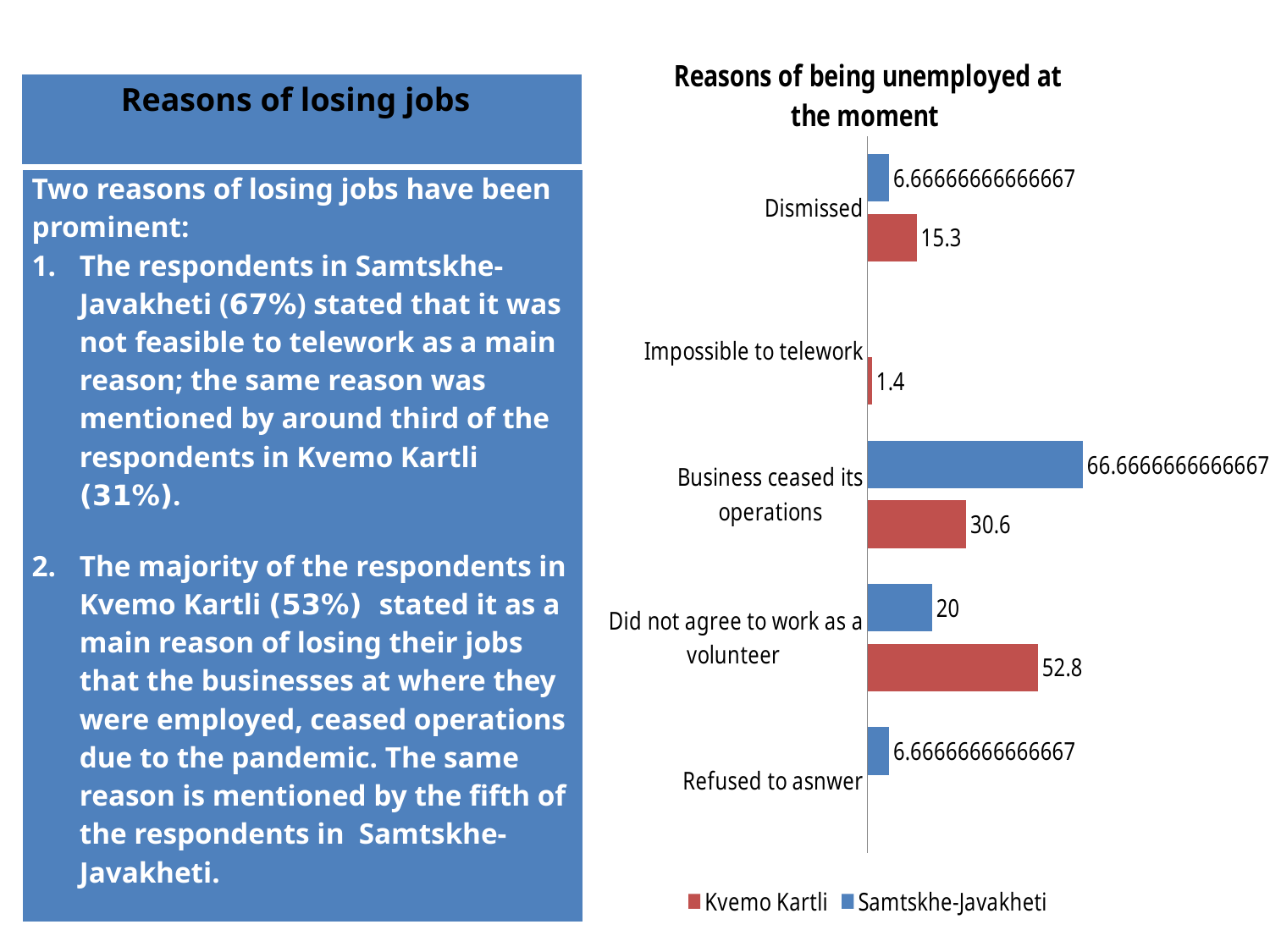
What is the value for Kvemo Kartli for 'Dismissed'? 15.3 What is the value for Samtskhe-Javakheti for 'Business ceased its operations'? 66.6666666666667 How many series does the legend list? 2 Which category has the lowest value for Kvemo Kartli? Impossible to telework What is the difference between the Kvemo Kartli and Samtskhe-Javakheti values for 'Did not agree to work as a volunteer'? 32.8 What kind of chart is shown on the slide? bar chart What is the value for Kvemo Kartli for 'Impossible to telework'? 1.4 For 'Dismissed', which region has the larger value, Kvemo Kartli or Samtskhe-Javakheti? Kvemo Kartli What is the value for Samtskhe-Javakheti for 'Did not agree to work as a volunteer'? 20 How many categories are shown on the chart? 5 What is the value for Kvemo Kartli for 'Business ceased its operations'? 30.6 Which category has the highest value for Kvemo Kartli? Did not agree to work as a volunteer